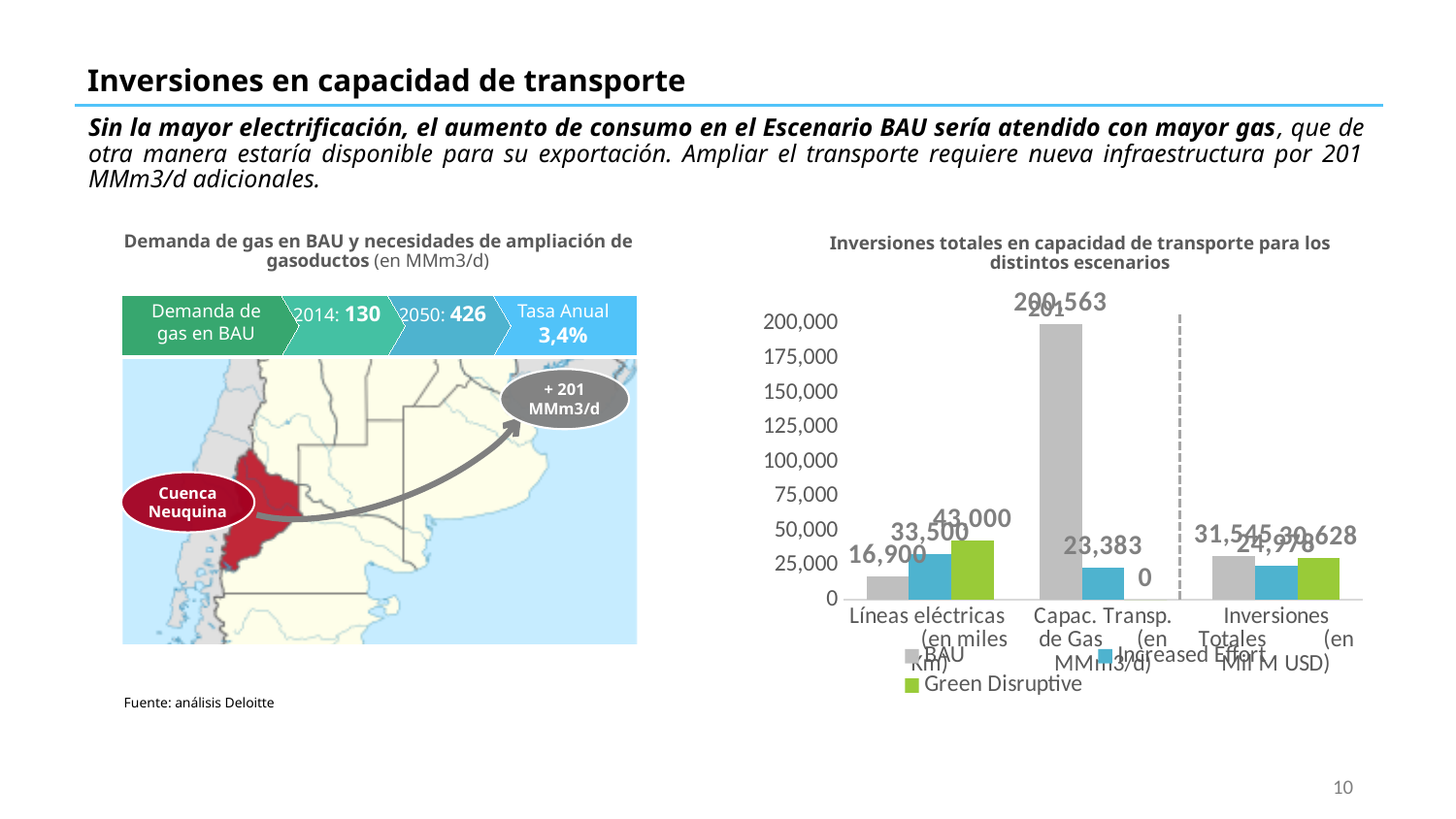
In the chart 'Inversiones totales en capacidad de transporte para los distintos escenarios', which scenario has the highest value for Líneas eléctricas? Green Disruptive In the chart 'Inversiones totales en capacidad de transporte para los distintos escenarios', which scenario has the lowest value for Capac. Transp. de Gas? Green Disruptive In the chart 'Inversiones totales en capacidad de transporte para los distintos escenarios', what is the Green Disruptive value for Líneas eléctricas? 43,000 In the chart 'Inversiones totales en capacidad de transporte para los distintos escenarios', what is the Increased Effort value for Inversiones Totales? 24,978 What kind of chart is 'Inversiones totales en capacidad de transporte para los distintos escenarios'? Bar chart In the chart 'Inversiones totales en capacidad de transporte para los distintos escenarios', what is the Green Disruptive value for Capac. Transp. de Gas? 0 In the chart 'Inversiones totales en capacidad de transporte para los distintos escenarios', what is the difference between the Green Disruptive and Increased Effort values for Líneas eléctricas? 9,500 In the chart 'Inversiones totales en capacidad de transporte para los distintos escenarios', is the BAU value for Capac. Transp. de Gas greater or less than 175,000? greater In the chart 'Inversiones totales en capacidad de transporte para los distintos escenarios', what is the BAU value for Líneas eléctricas? 16,900 In the chart 'Inversiones totales en capacidad de transporte para los distintos escenarios', is the Increased Effort value larger for Líneas eléctricas or for Capac. Transp. de Gas? Líneas eléctricas How many series does the legend of the chart 'Inversiones totales en capacidad de transporte para los distintos escenarios' list? 3 In the chart 'Inversiones totales en capacidad de transporte para los distintos escenarios', what is the Increased Effort value for Capac. Transp. de Gas? 23,383